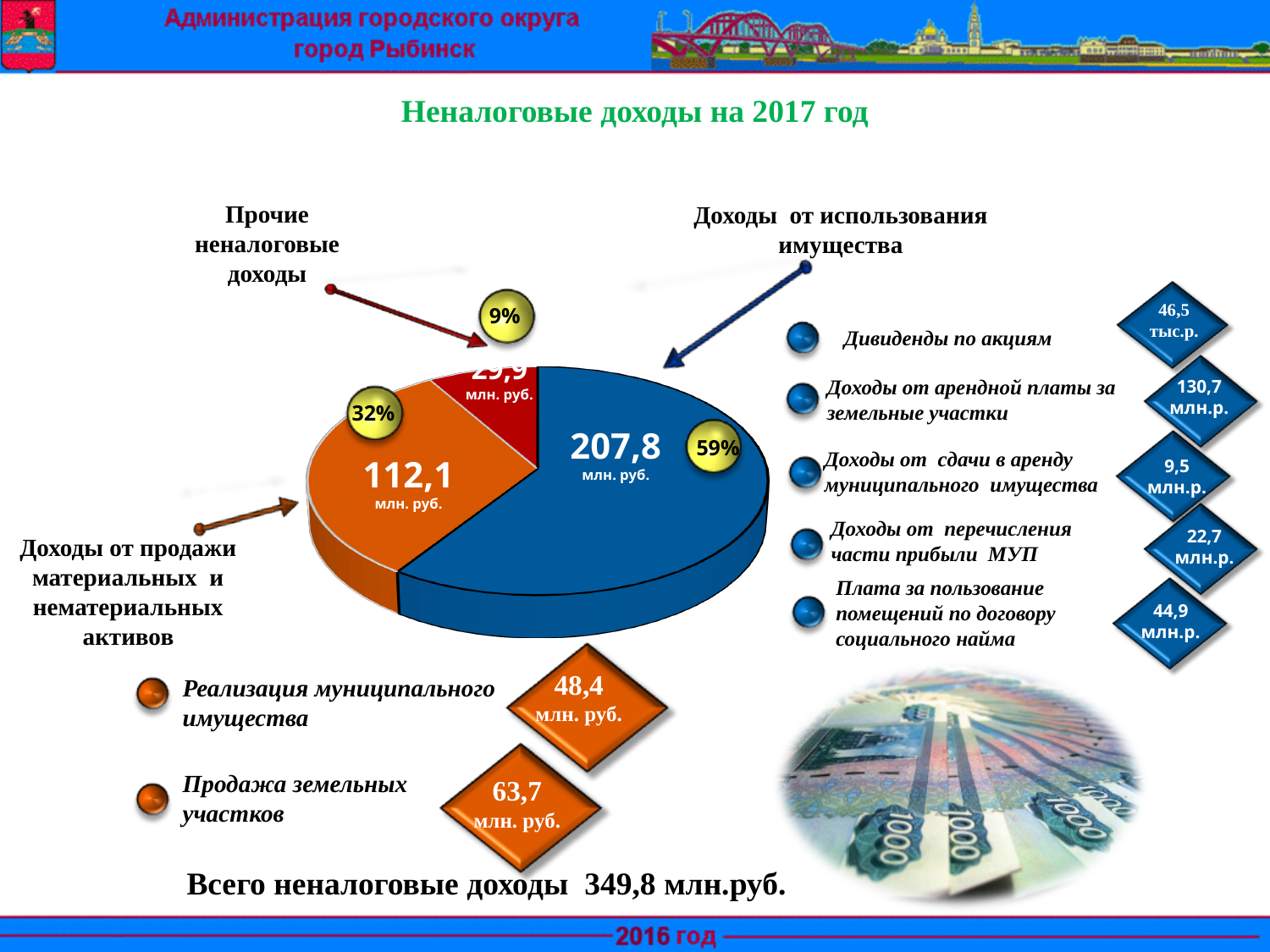
What value is shown for the slice 'Доходы от продажи материальных и нематериальных активов' in the pie chart? 112,1 млн. руб. Which is larger: 'Доходы от использования имущества' or 'Доходы от продажи материальных и нематериальных активов'? Доходы от использования имущества What is the title of the slide containing the chart? Неналоговые доходы на 2017 год What percentage share of the pie does 'Доходы от продажи материальных и нематериальных активов' have? 32% Which category has the smallest slice in the pie chart? Прочие неналоговые доходы How many slices does the pie chart have? 3 What type of chart is shown on the slide? Pie chart What is the difference between the values for 'Доходы от использования имущества' and 'Доходы от продажи материальных и нематериальных активов'? 95,7 млн. руб. What percentage share of the pie does 'Доходы от использования имущества' have? 59% What percentage share of the pie does 'Прочие неналоговые доходы' have? 9% Which category has the largest slice in the pie chart? Доходы от использования имущества What value is shown for the slice 'Доходы от использования имущества' in the pie chart? 207,8 млн. руб.